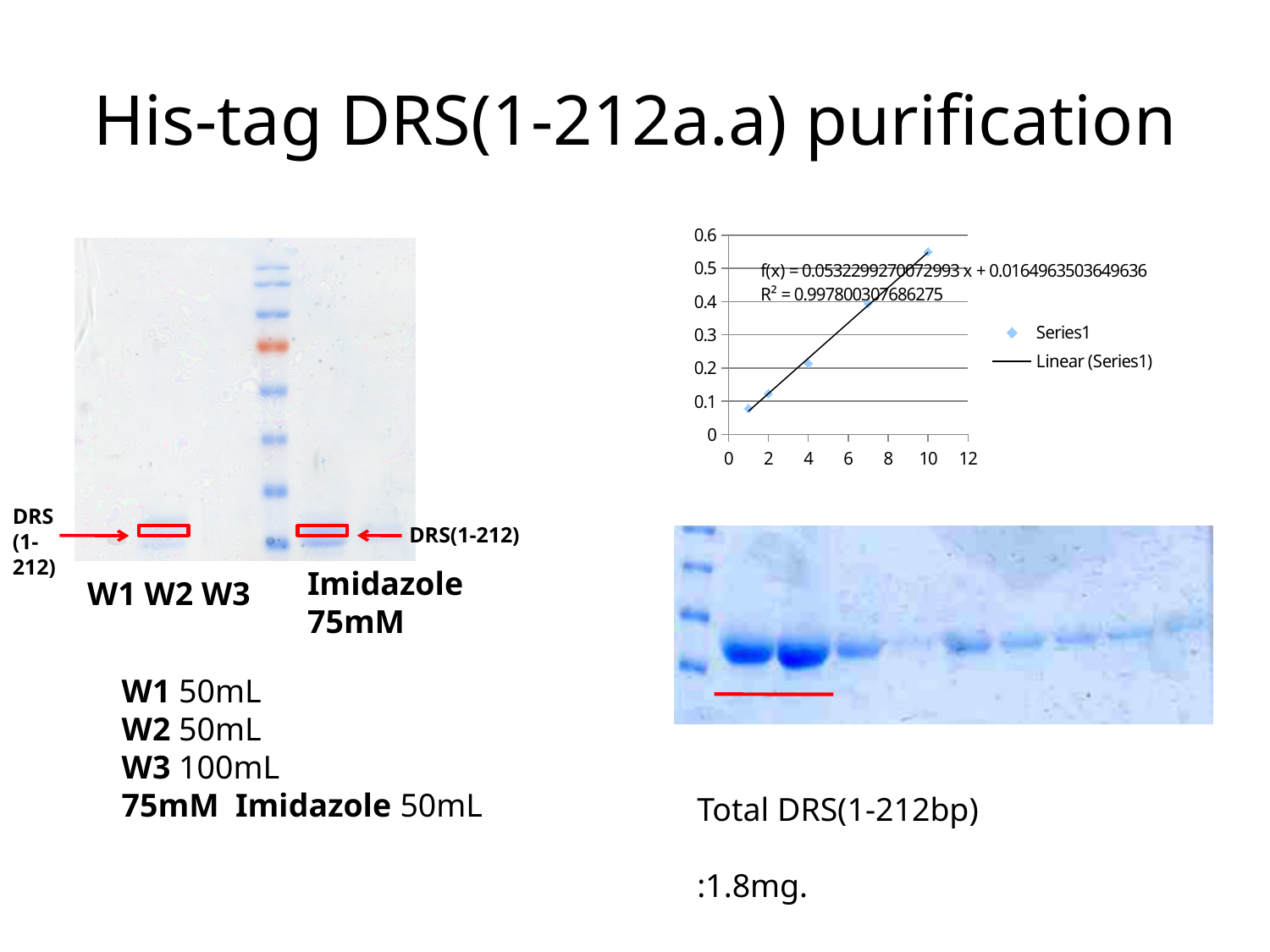
How many entries does the chart's legend list? 2 Is the value of the data point at x = 1 greater or less than 0.1? less Is the value of the data point at x = 4 greater or less than 0.3? less Is the value of the data point at x = 7 greater or less than 0.3? greater What R² value is displayed on the chart for the linear trendline? 0.997800307686275 At which x value is the lowest plotted point located? 1 Do the plotted values rise or fall as x increases along the x axis? rise How many data points are plotted in the chart? 5 What kind of chart is shown on the slide? scatter chart At which x value is the highest plotted point located? 10 What are the two entries in the chart's legend? Series1 and Linear (Series1)